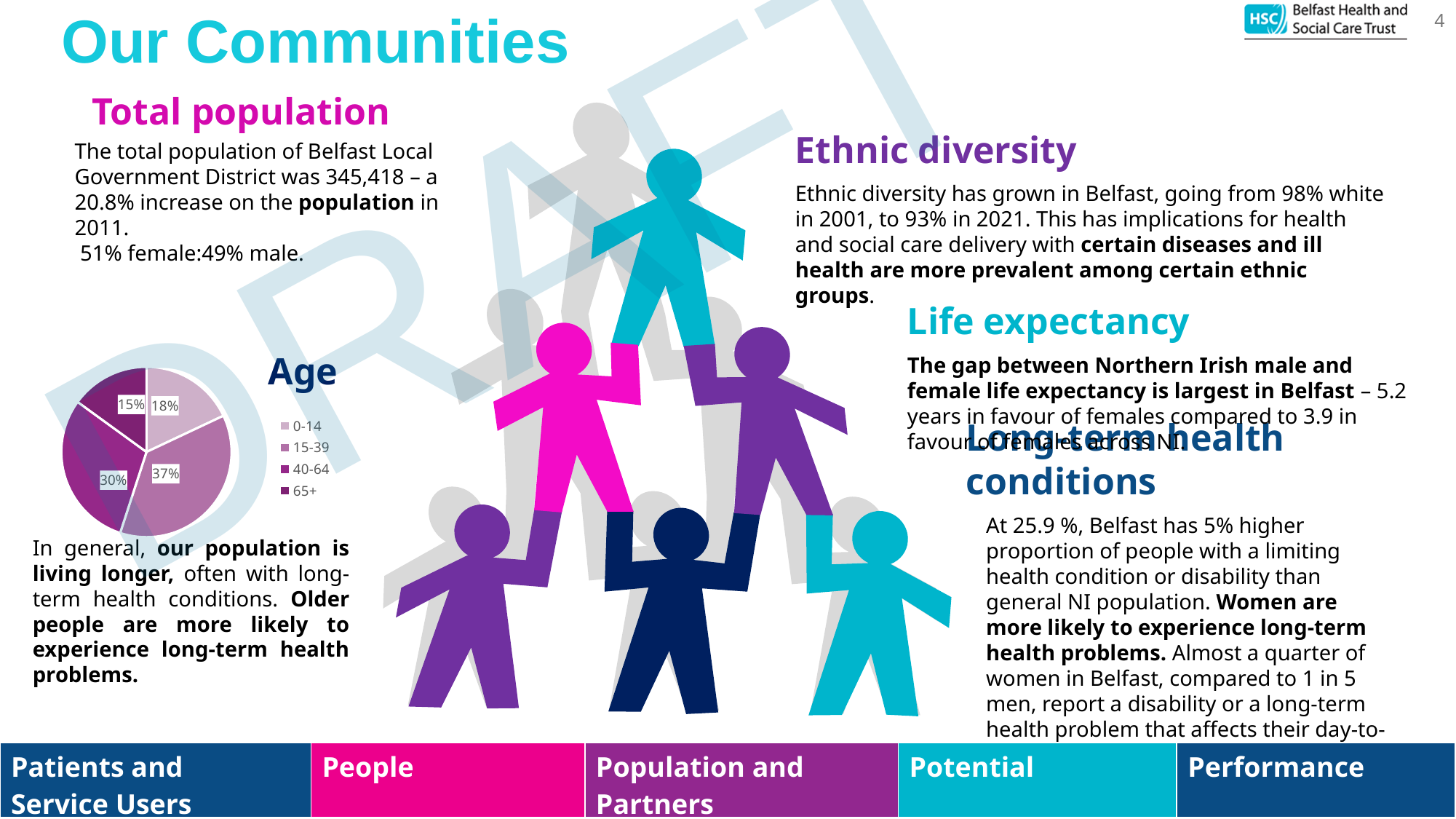
Which age group has the smallest slice in the Age pie chart? 65+ In the Age pie chart, what share of the population is aged 65+? 15% In the Age pie chart, what is the difference between the 15-39 share and the 40-64 share? 7% In the Age pie chart, what share of the population is aged 0-14? 18% In the Age pie chart, what share of the population is aged 15-39? 37% How many age groups are shown in the Age pie chart? 4 In the Age pie chart, which is larger: the 0-14 slice or the 65+ slice? 0-14 What kind of chart is the Age chart? pie chart Which age group has the largest slice in the Age pie chart? 15-39 How many entries does the legend of the Age pie chart list? 4 In the Age pie chart, what is the combined share of the 40-64 and 65+ groups? 45% In the Age pie chart, what share of the population is aged 40-64? 30%